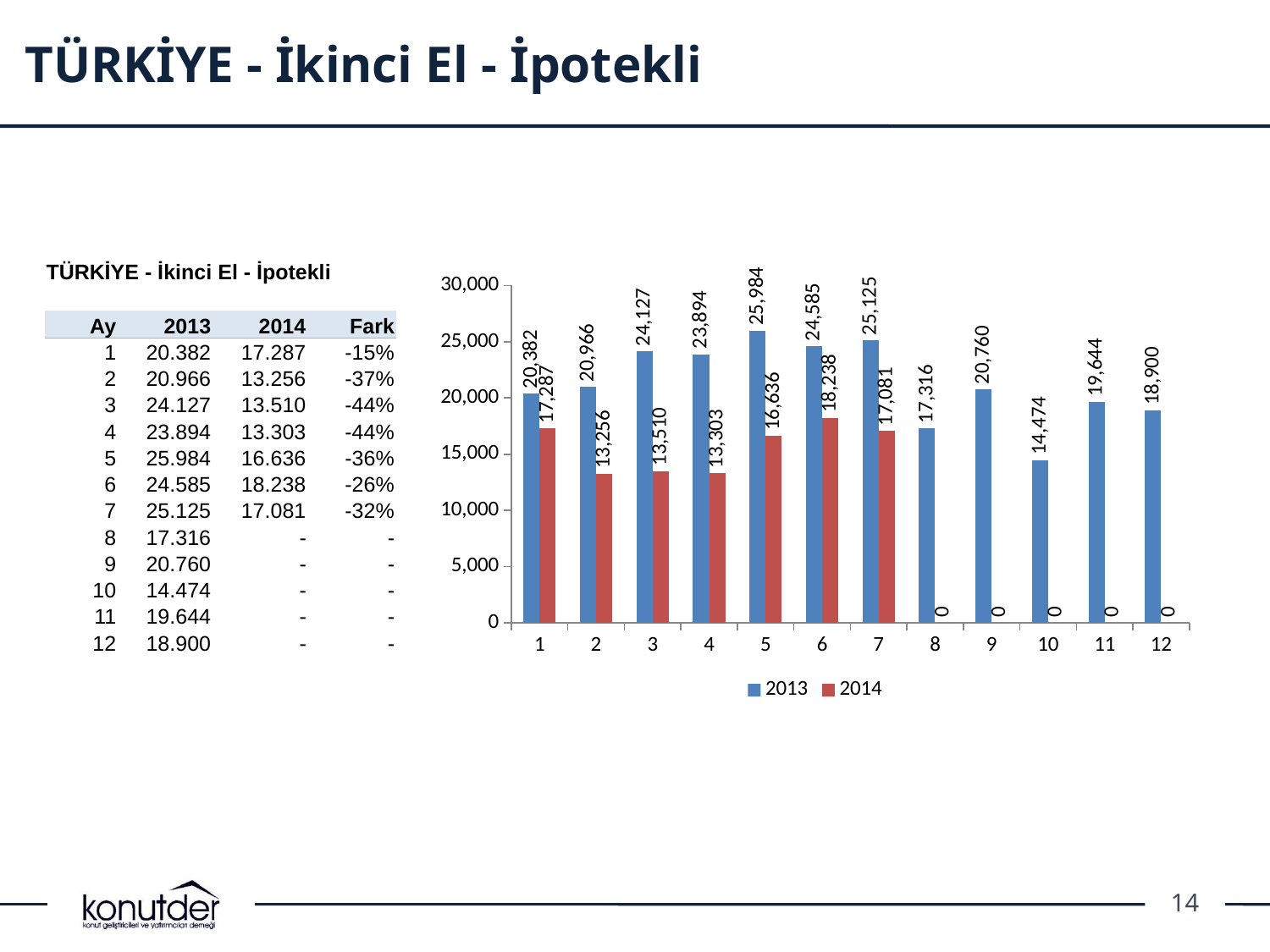
Which month has the highest 2013 value? 5 Among months 1 to 7, which month has the highest 2014 value? 6 What is the 2013 value for month 5? 25,984 Which month has the lowest 2013 value? 10 What is the 2014 value for month 6? 18,238 What is the difference between the 2013 and 2014 values for month 1? 3,095 What kind of chart is shown on the slide? Bar chart How many months are shown on the x axis? 12 Which colour represents the 2014 series in the chart? Red Which is larger: the 2014 value for month 6 or the 2014 value for month 7? Month 6 (18,238) What is the 2014 value shown for month 8? 0 How many series does the legend list? 2